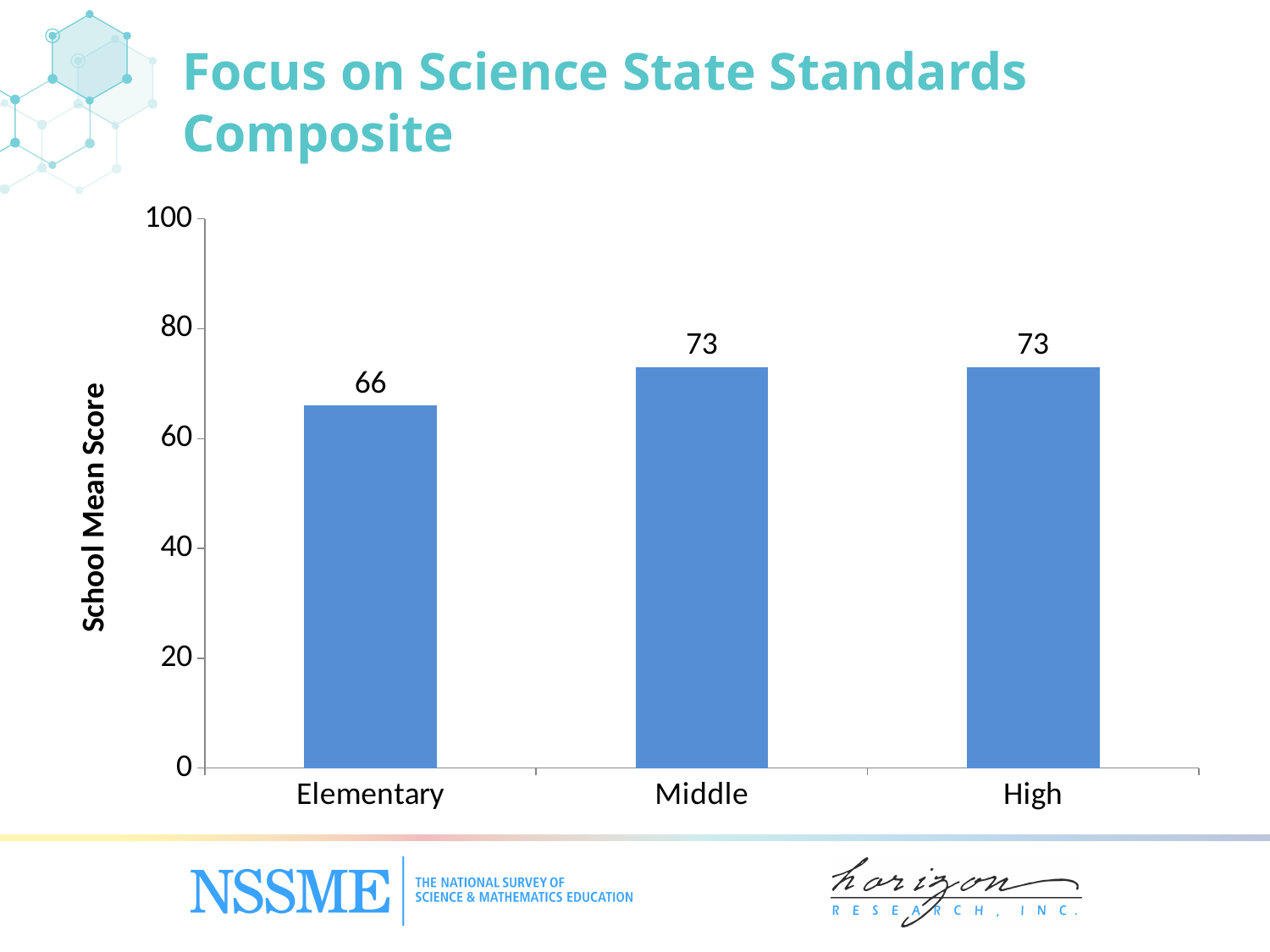
Which school level has the lowest school mean score? Elementary What is the school mean score for Elementary? 66 How many school levels are shown on the x axis? 3 Is the value for Middle greater or less than 80? less What is the school mean score for High? 73 Is the value for Elementary greater or less than 60? greater Which has a higher school mean score, Elementary or High? High What is the school mean score for Middle? 73 What is the title of the slide? Focus on Science State Standards Composite What is the label of the y axis? School Mean Score What kind of chart is shown on the slide? bar chart What is the difference between the school mean scores for Middle and Elementary? 7